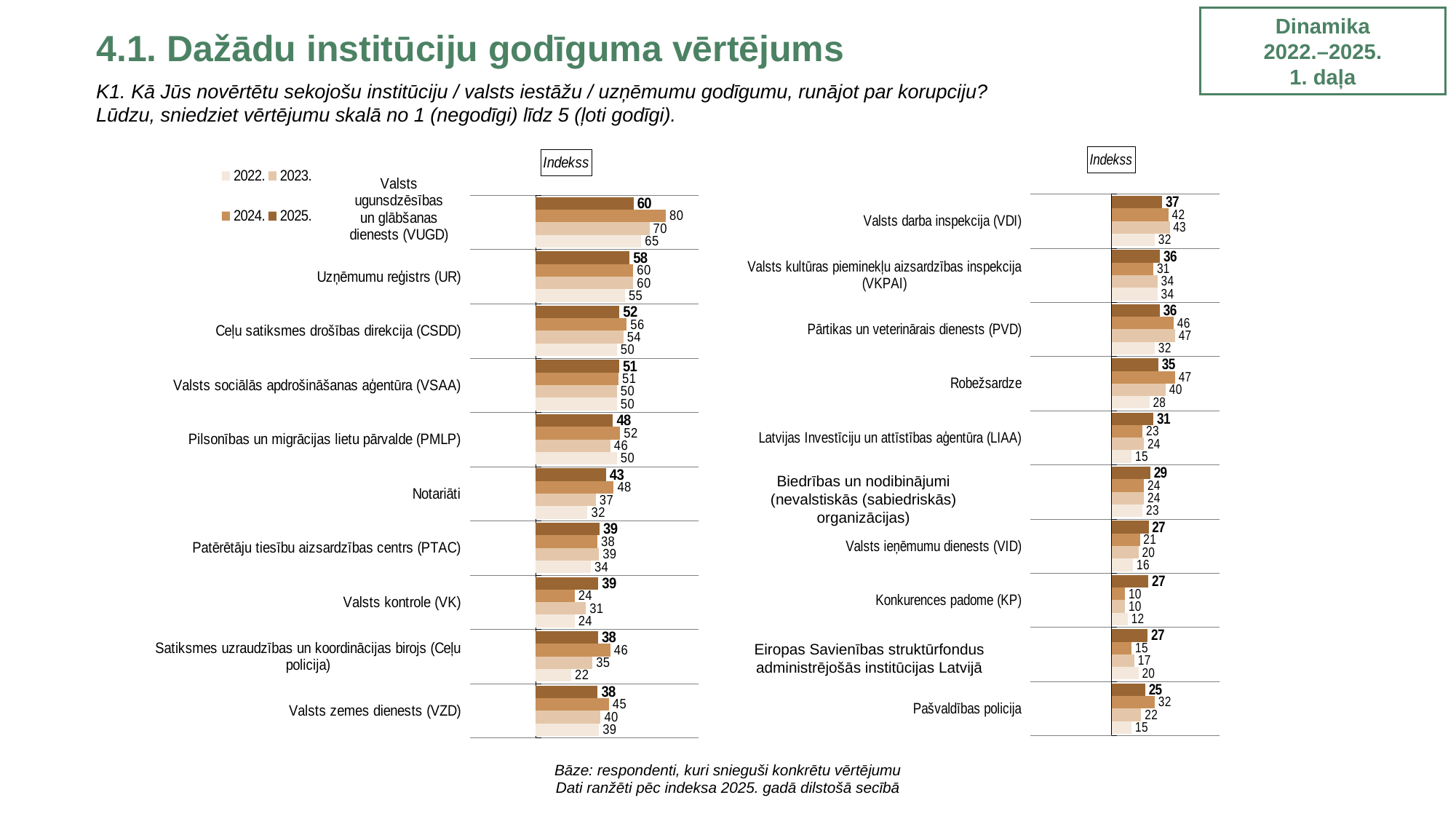
How many series does the legend list? 4 On the left chart, which institution has the highest 2025 index value? Valsts ugunsdzēsības un glābšanas dienests (VUGD) On the left chart, what is the 2025 index value for Valsts ugunsdzēsības un glābšanas dienests (VUGD)? 60 On the right chart, which institution has the lowest 2025 index value? Pašvaldības policija On the right chart, what is the 2022 index value for Konkurences padome (KP)? 12 On the left chart, what is the 2024 index value for Valsts ugunsdzēsības un glābšanas dienests (VUGD)? 80 How many institutions are shown on the right chart? 10 Which years are listed in the legend? 2022, 2023, 2024, 2025 On the left chart, what is the difference between the 2024 and 2025 index values for Notariāti? 5 On the right chart, what is the difference between the 2025 and 2022 index values for Latvijas Investīciju un attīstības aģentūra (LIAA)? 16 On the right chart, which is larger for Robežsardze: the 2024 value or the 2025 value? 2024 What type of chart is used on the slide? Bar chart